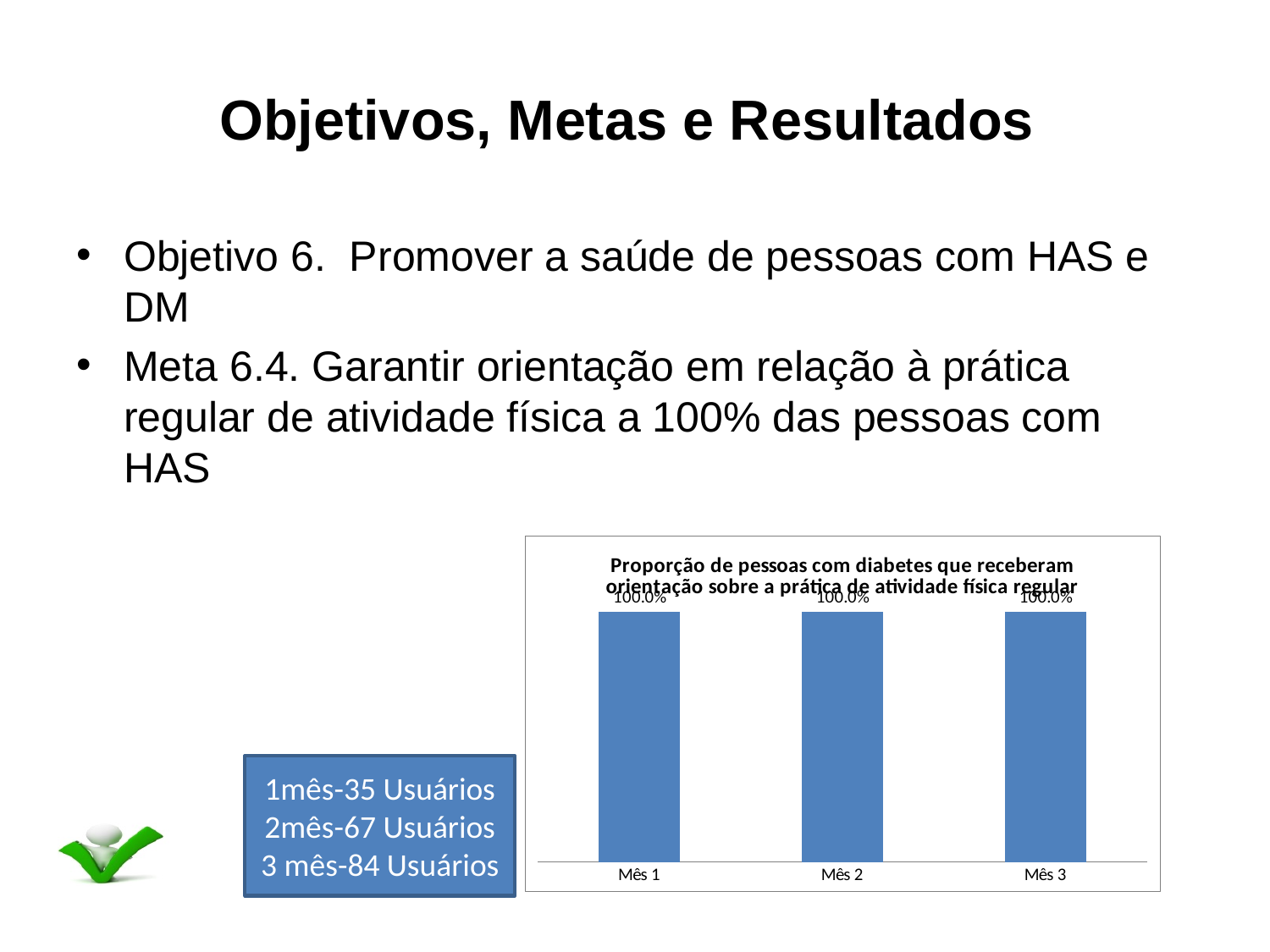
What kind of chart is shown on the slide? bar chart Do the values rise, fall or stay the same from Mês 1 to Mês 3? stay the same What is the value for Mês 3? 100.0% How many categories are shown on the x axis of the chart? 3 What is the label of the first category on the x axis? Mês 1 What is the value for Mês 2? 100.0% What is the title of the chart? Proporção de pessoas com diabetes que receberam orientação sobre a prática de atividade física regular What is the difference between the values for Mês 1 and Mês 3? 0.0% What colour are the bars in the chart? blue What is the value for Mês 1? 100.0%